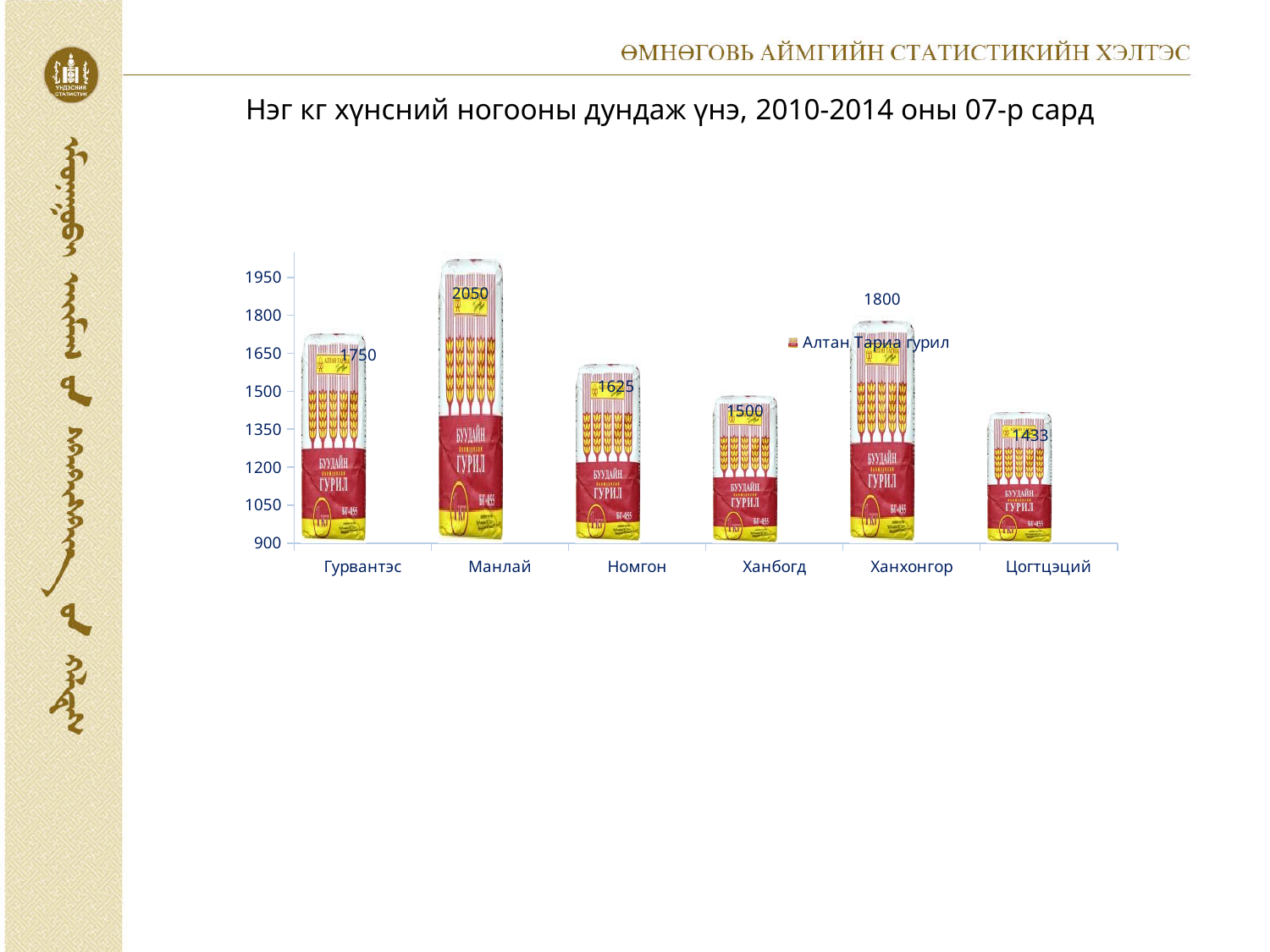
How many series does the legend list? 1 What is the value for Манлай? 2050 Which category has the highest value? Манлай Which category has the lowest value? Цогтцэций How many categories are shown on the x axis? 6 What series name is shown in the legend? Алтан Тариа гурил What is the difference between the values for Манлай and Гурвантэс? 300 What is the value for Ханбогд? 1500 What kind of chart is shown on the slide? bar chart What is the value for Цогтцэций? 1433 Which is larger, the value for Номгон or the value for Ханбогд? Номгон What is the value for Ханхонгор? 1800